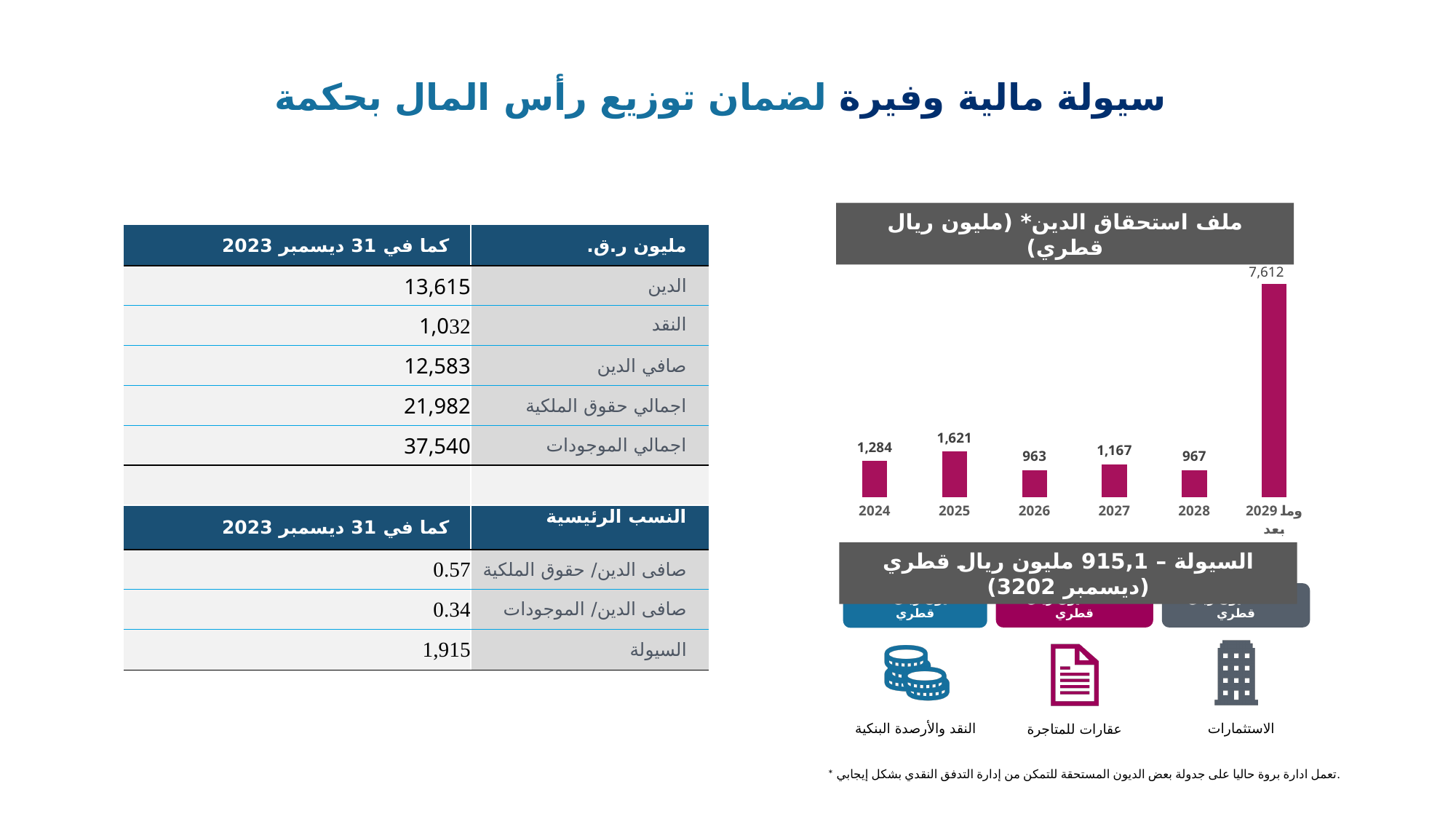
What is the value labelled on the bar for 2027? 1,167 Which year has the lowest value in the debt maturity chart? 2026 Which is larger in the debt maturity chart, the value for 2027 or the value for 2028? 2027 What is the value shown for 2025 in the debt maturity chart? 1,621 What is the difference between the values for 2025 and 2024 in the bar chart? 337 What type of chart is used to show the debt maturity profile? Bar chart What unit is stated in the title of the debt maturity chart? مليون ريال قطري What is the value shown for 2029 and beyond in the debt maturity chart? 7,612 What value does the bar chart show for 2026? 963 What is the debt maturity value shown for 2024 in the bar chart? 1,284 How many year categories are shown in the debt maturity bar chart? 6 Which year category has the highest value in the debt maturity chart? 2029 and beyond